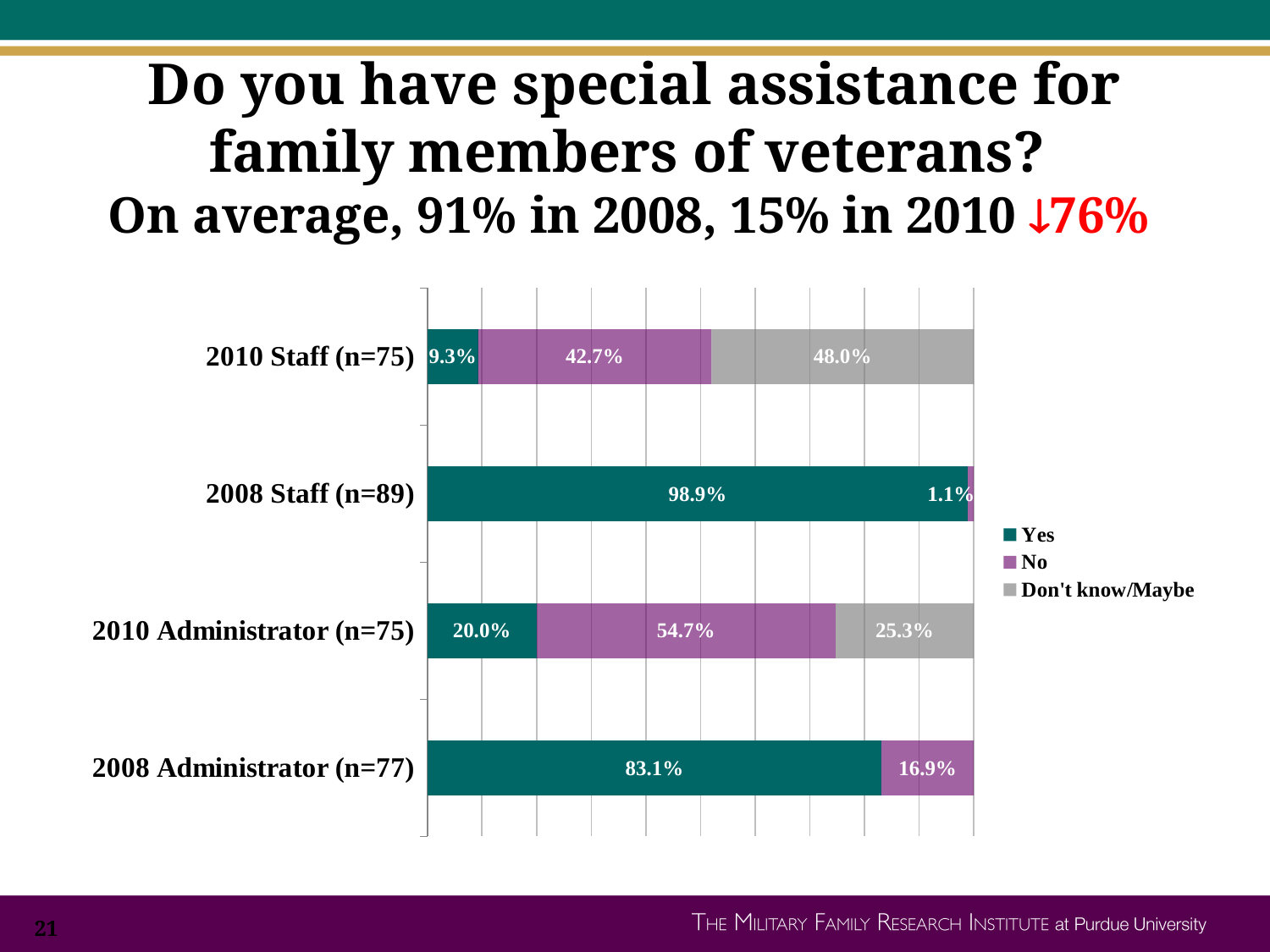
What is the 'Don't know/Maybe' value for 2010 Staff (n=75)? 48.0% What is the 'Yes' value for 2010 Staff (n=75)? 9.3% How many categories are shown on the chart? 4 How many series does the legend list? 3 Which is larger: the 'No' value for 2010 Staff (n=75) or the 'No' value for 2010 Administrator (n=75)? 2010 Administrator (n=75) Which category has the highest 'Yes' value? 2008 Staff (n=89) Which category has the lowest 'Yes' value? 2010 Staff (n=75) What is the 'No' value for 2008 Staff (n=89)? 1.1% What is the difference between the 'Yes' values for 2008 Administrator (n=77) and 2010 Administrator (n=75)? 63.1% What is the 'Yes' value for 2008 Administrator (n=77)? 83.1% What is the 'No' value for 2010 Administrator (n=75)? 54.7% What kind of chart is shown on the slide? Stacked bar chart